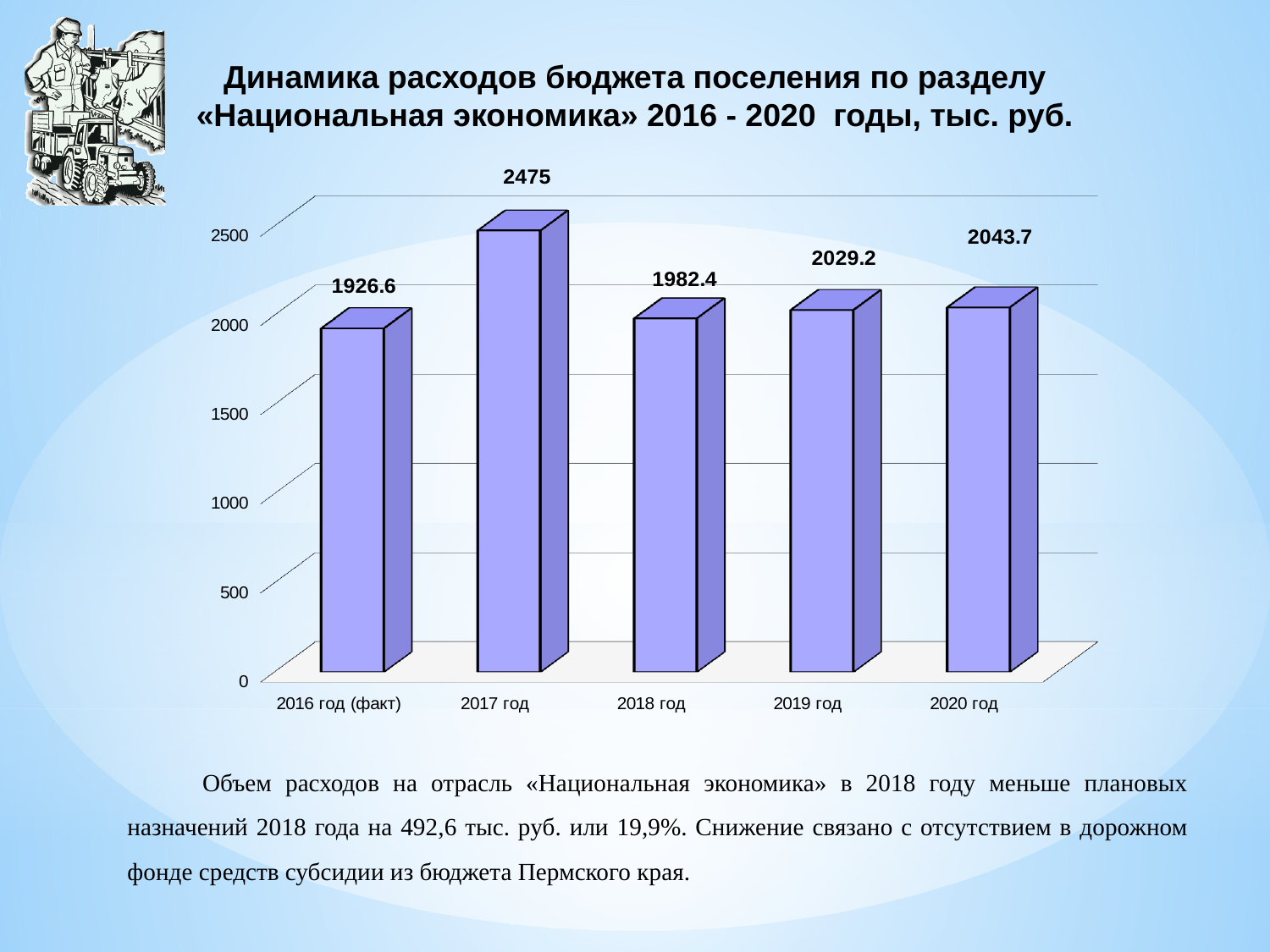
What is the value for 2017 год? 2475 Do the values rise or fall from 2018 год to 2020 год? rise Which year has the lowest value? 2016 год (факт) What is the difference between the values for 2017 год and 2018 год? 492.6 What is the value for 2016 год (факт)? 1926.6 Which year has the highest value? 2017 год How many years are shown on the chart? 5 Is the value for 2017 год greater or less than 2000? greater What kind of chart is shown on the slide? bar chart Which is larger, the value for 2019 год or the value for 2018 год? 2019 год What is the value for 2020 год? 2043.7 What unit of measurement is stated in the chart title? тыс. руб.